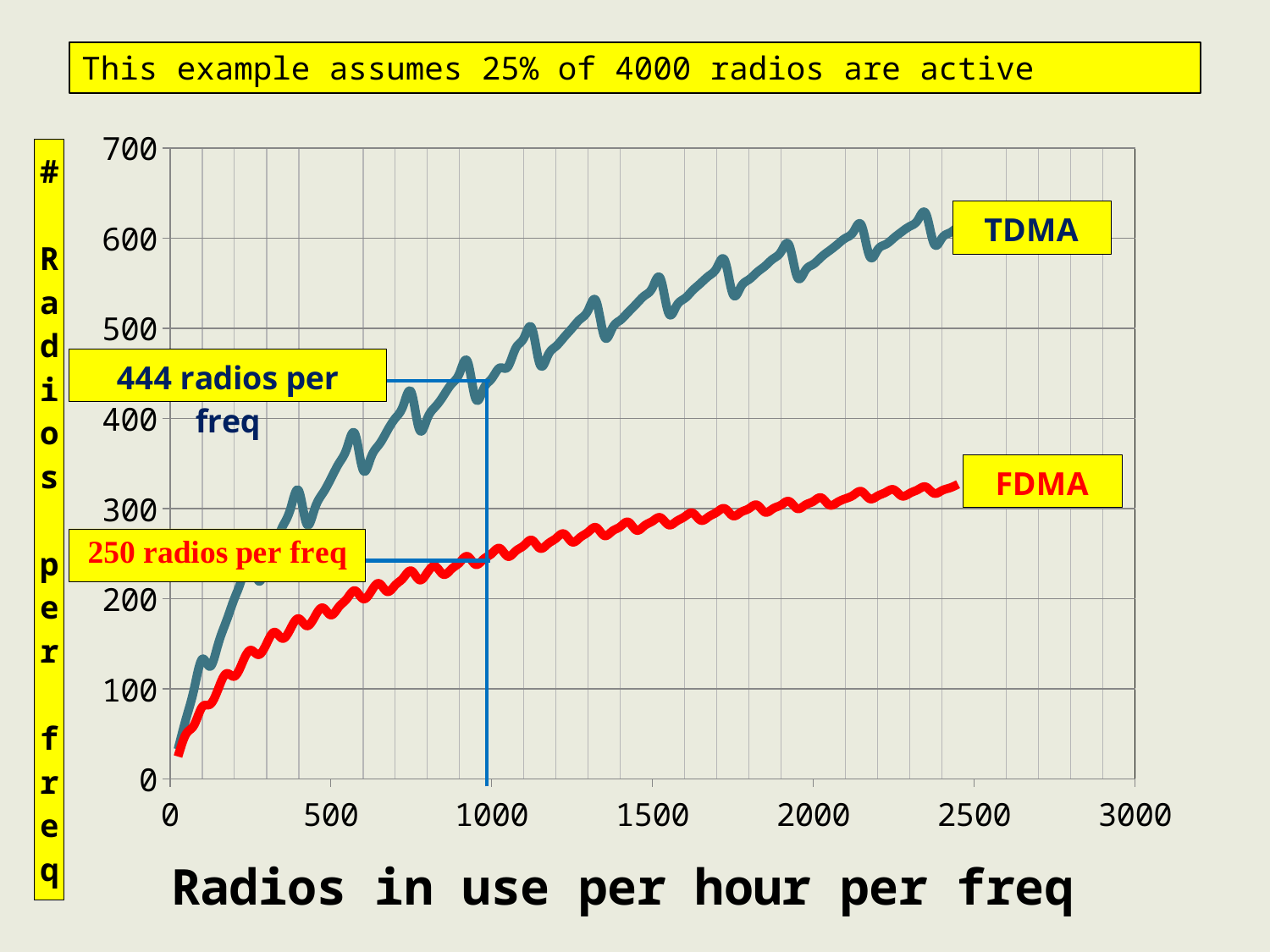
At 1000 radios in use per hour per freq, which series has the larger value, TDMA or FDMA? TDMA What is the title of the x axis? Radios in use per hour per freq What are the names of the two series plotted on the chart? TDMA and FDMA Is the FDMA value at 2000 radios in use per hour per freq greater or less than 400? less At 1000 radios in use per hour per freq, what is the difference between the TDMA and FDMA values? 194 Which series reaches the higher values across the chart, TDMA or FDMA? TDMA According to the annotation, how many radios per freq does FDMA support at 1000 radios in use per hour per freq? 250 radios per freq Is the TDMA value at 2000 radios in use per hour per freq greater or less than 500? greater What kind of chart is shown on the slide? line chart How many series are plotted on the chart? 2 Do the values of the TDMA series rise or fall as radios in use per hour per freq increases? rise According to the annotation, how many radios per freq does TDMA support at 1000 radios in use per hour per freq? 444 radios per freq